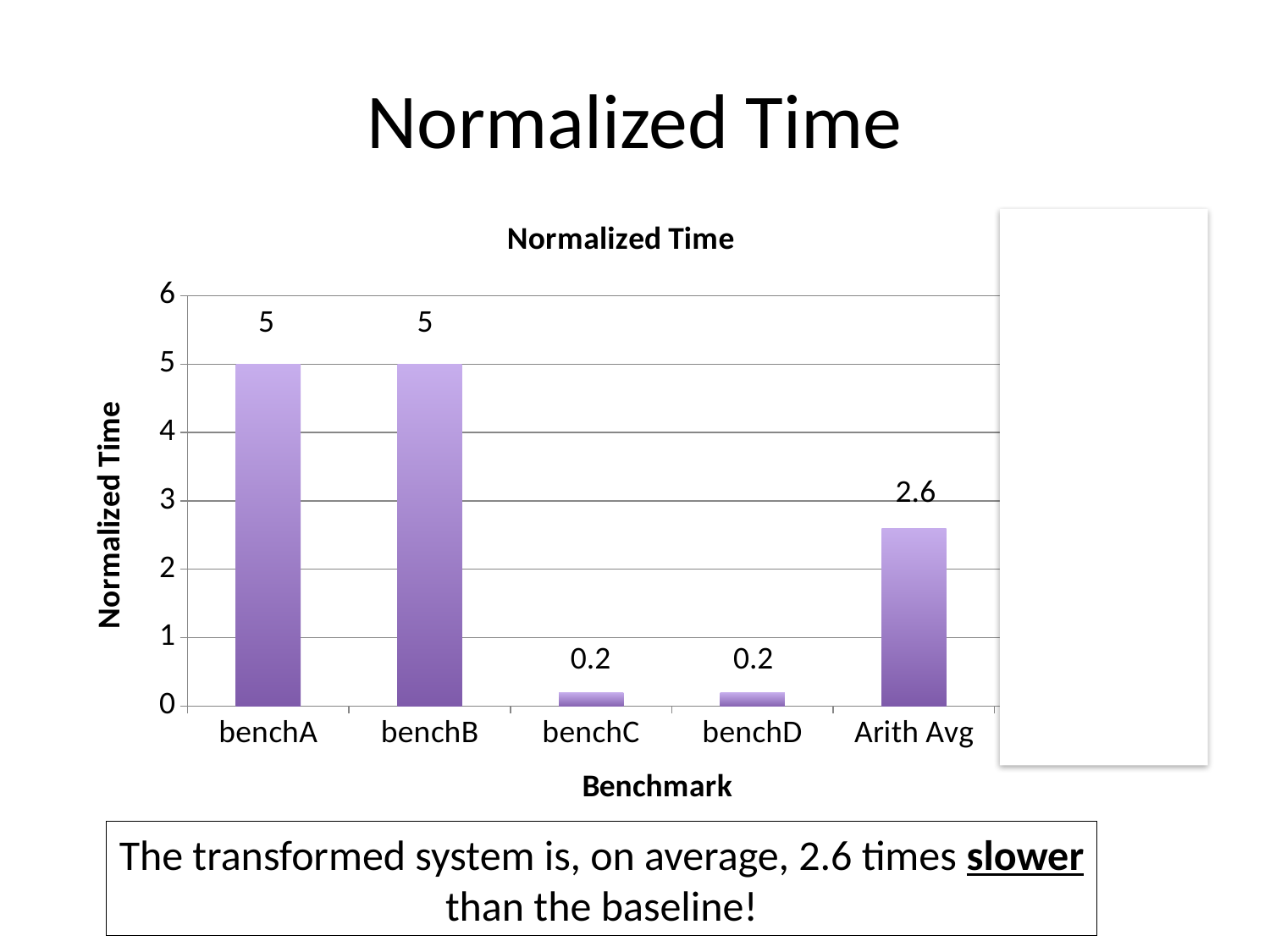
What is the value shown for Arith Avg? 2.6 What is the normalized time for benchA? 5 What kind of chart is shown on the slide? bar chart What is the label of the y axis? Normalized Time What is the difference between the normalized time for benchB and benchD? 4.8 Is the value for benchD greater or less than 1? less What is the label of the x axis? Benchmark Is the value for Arith Avg greater or less than 2? greater What is the normalized time for benchC? 0.2 What is the difference between the value for benchA and the Arith Avg value? 2.4 Which benchmark has the lowest normalized time, benchC or Arith Avg? benchC How many categories are shown on the x axis? 5